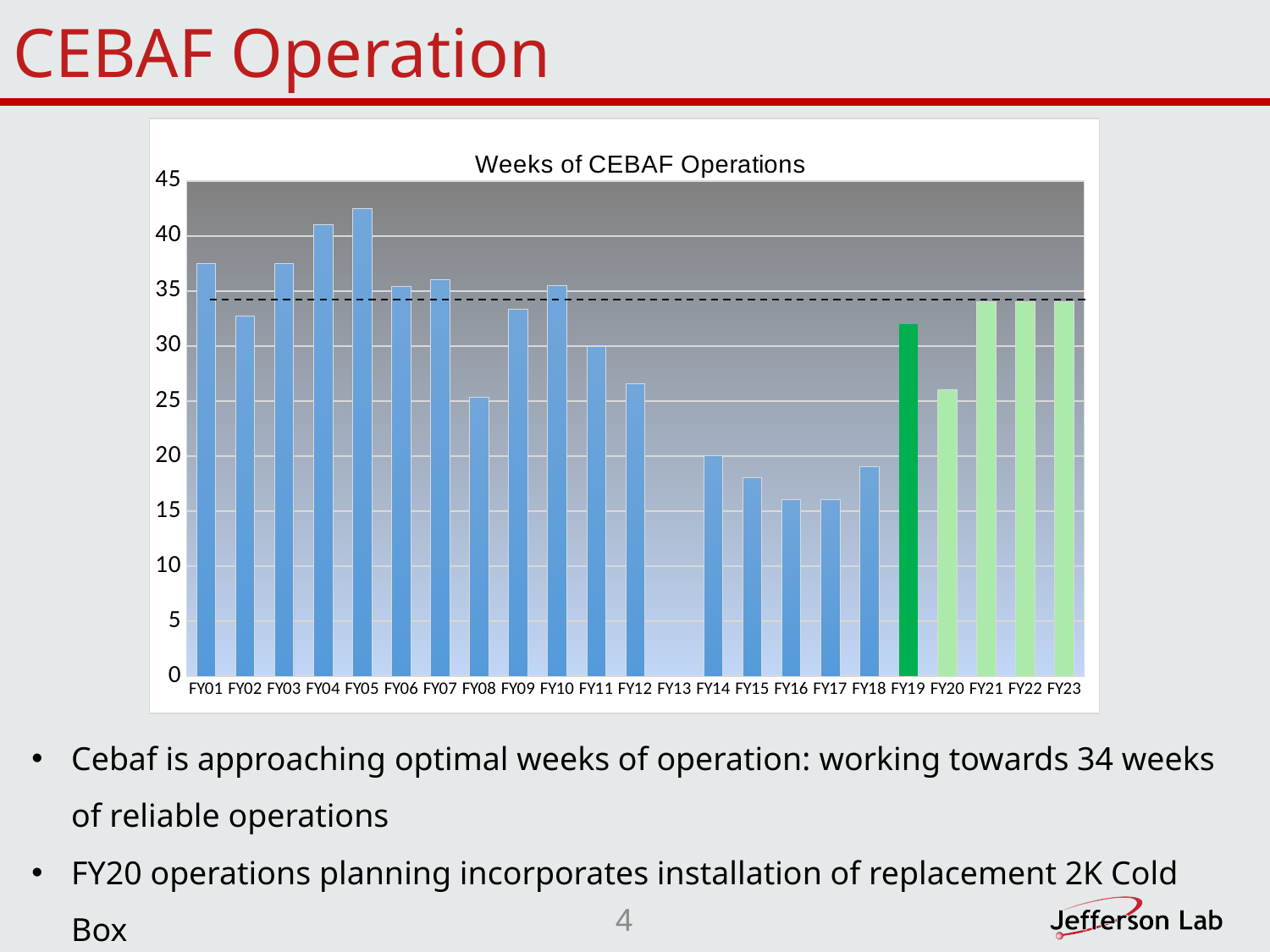
Is the value for FY20 greater or less than 30? less Do the values rise or fall from FY14 to FY17? fall Which is larger, the value for FY01 or the value for FY02? FY01 Is the value for FY14 greater or less than 25? less What kind of chart is shown on the slide? bar chart Is the value for FY21 greater or less than 30? greater Which is larger, the value for FY19 or the value for FY20? FY19 How many fiscal years are labelled on the x axis of the chart? 23 What is the title of the chart? Weeks of CEBAF Operations Which fiscal year has the highest number of weeks of CEBAF operations? FY05